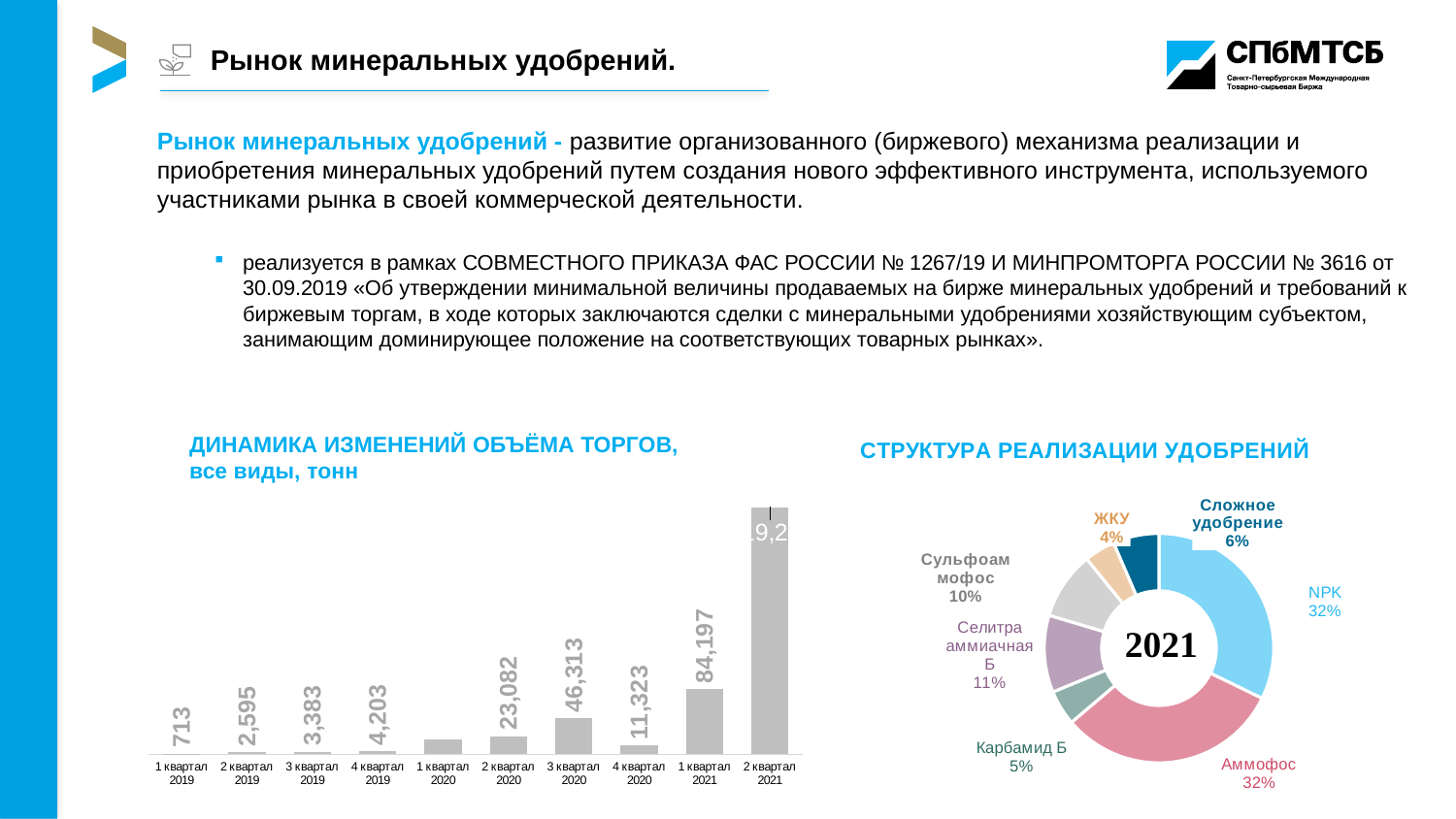
In the chart 'ДИНАМИКА ИЗМЕНЕНИЙ ОБЪЁМА ТОРГОВ, все виды, тонн', what is the value for 3 квартал 2020? 46,313 In the chart 'ДИНАМИКА ИЗМЕНЕНИЙ ОБЪЁМА ТОРГОВ, все виды, тонн', which is larger: the value for 2 квартал 2020 or 4 квартал 2020? 2 квартал 2020 How many categories are shown in the chart 'СТРУКТУРА РЕАЛИЗАЦИИ УДОБРЕНИЙ'? 7 How many bars are shown in the chart 'ДИНАМИКА ИЗМЕНЕНИЙ ОБЪЁМА ТОРГОВ, все виды, тонн'? 10 In the chart 'СТРУКТУРА РЕАЛИЗАЦИИ УДОБРЕНИЙ', which category has the smallest share? ЖКУ What year is written in the centre of the chart 'СТРУКТУРА РЕАЛИЗАЦИИ УДОБРЕНИЙ'? 2021 In the chart 'ДИНАМИКА ИЗМЕНЕНИЙ ОБЪЁМА ТОРГОВ, все виды, тонн', which quarter has the lowest value? 1 квартал 2019 What kind of chart is 'ДИНАМИКА ИЗМЕНЕНИЙ ОБЪЁМА ТОРГОВ, все виды, тонн'? Bar chart In the chart 'ДИНАМИКА ИЗМЕНЕНИЙ ОБЪЁМА ТОРГОВ, все виды, тонн', what is the difference between the values for 1 квартал 2021 and 3 квартал 2020? 37,884 In the chart 'ДИНАМИКА ИЗМЕНЕНИЙ ОБЪЁМА ТОРГОВ, все виды, тонн', what is the value for 1 квартал 2021? 84,197 In the chart 'СТРУКТУРА РЕАЛИЗАЦИИ УДОБРЕНИЙ', what share does Карбамид Б have? 5% In the chart 'ДИНАМИКА ИЗМЕНЕНИЙ ОБЪЁМА ТОРГОВ, все виды, тонн', which quarter has the highest value? 2 квартал 2021